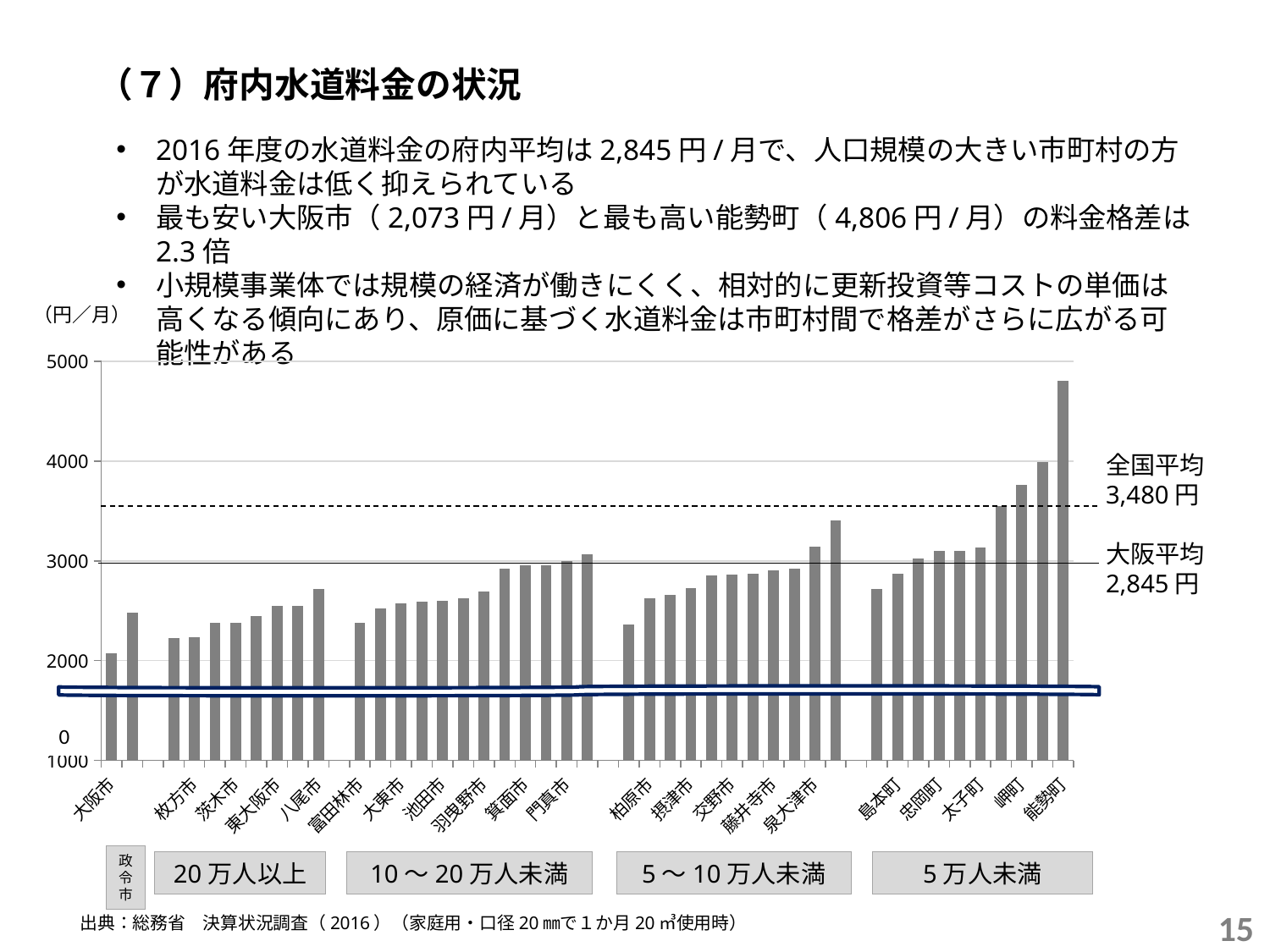
Is the value for 能勢町 greater or less than 4000? greater What value is shown for the 全国平均 reference line? 3,480円 What is the monthly water rate for 能勢町 stated on the slide? 4,806円/月 Which has the larger water rate, 岬町 or 島本町? 岬町 Is the value for 柏原市 greater or less than 3000? less What is the difference between the water rate of 能勢町 and that of 大阪市? 2,733円/月 What kind of chart is shown on the slide? bar chart Which municipality has the highest water rate in the chart? 能勢町 Which municipality has the lowest water rate in the chart? 大阪市 What value is shown for the 大阪平均 reference line? 2,845円 What is the monthly water rate for 大阪市 stated on the slide? 2,073円/月 Is the value for 泉大津市 greater or less than 3000? greater